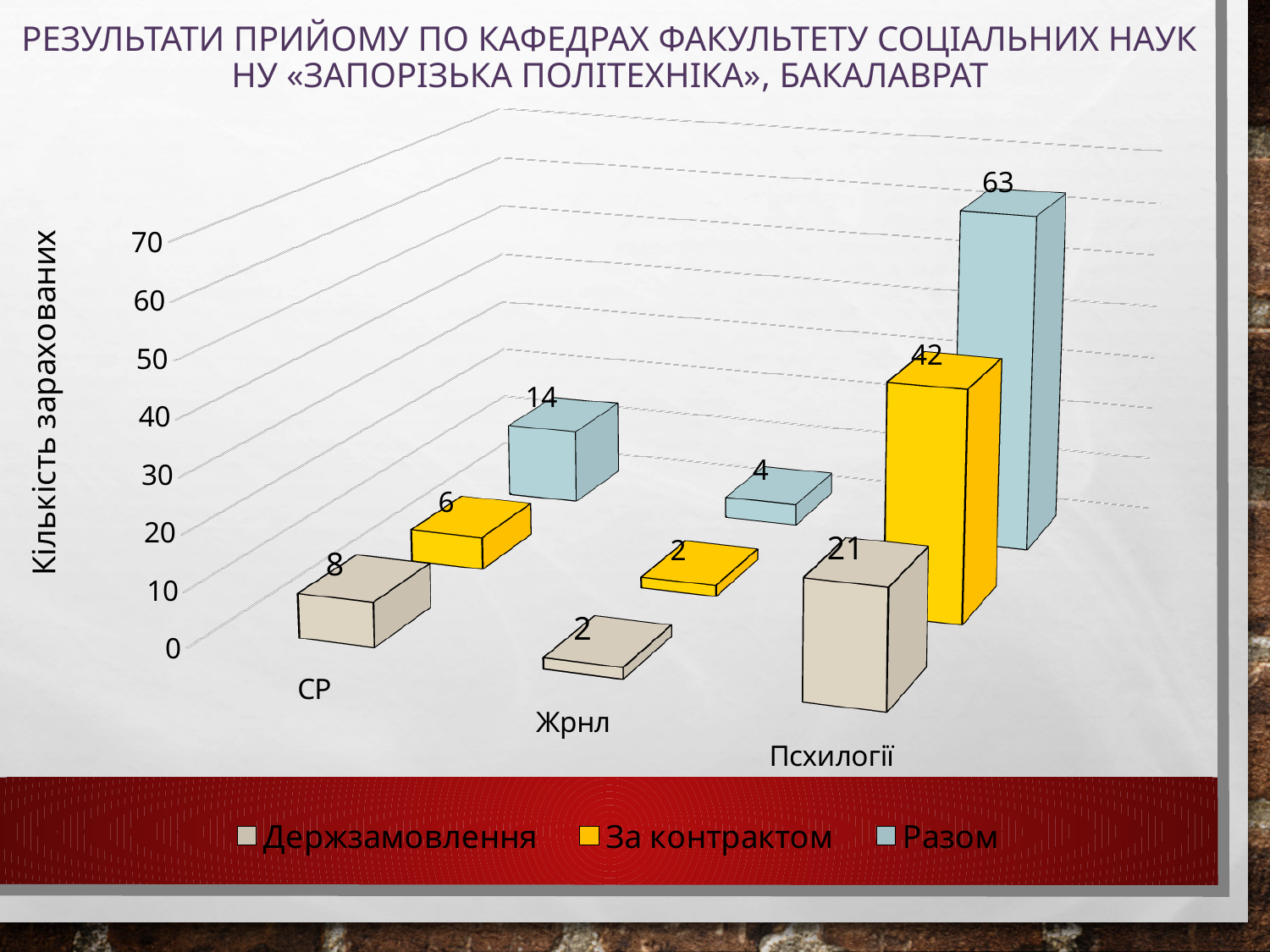
What is the value of За контрактом for Псхилогії? 42 What is the label of the vertical axis? Кількість зарахованих Which category has the lowest За контрактом value? Жрнл Which series is shown in yellow? За контрактом What is the difference between the Разом values for Псхилогії and СР? 49 How many series does the legend list? 3 Which is larger: Держзамовлення for Псхилогії or За контрактом for Псхилогії? За контрактом for Псхилогії What is the value of Разом for Жрнл? 4 Which category has the highest Разом value? Псхилогії How many categories are shown on the x axis? 3 What is the value of Держзамовлення for СР? 8 What kind of chart is shown on the slide? bar chart